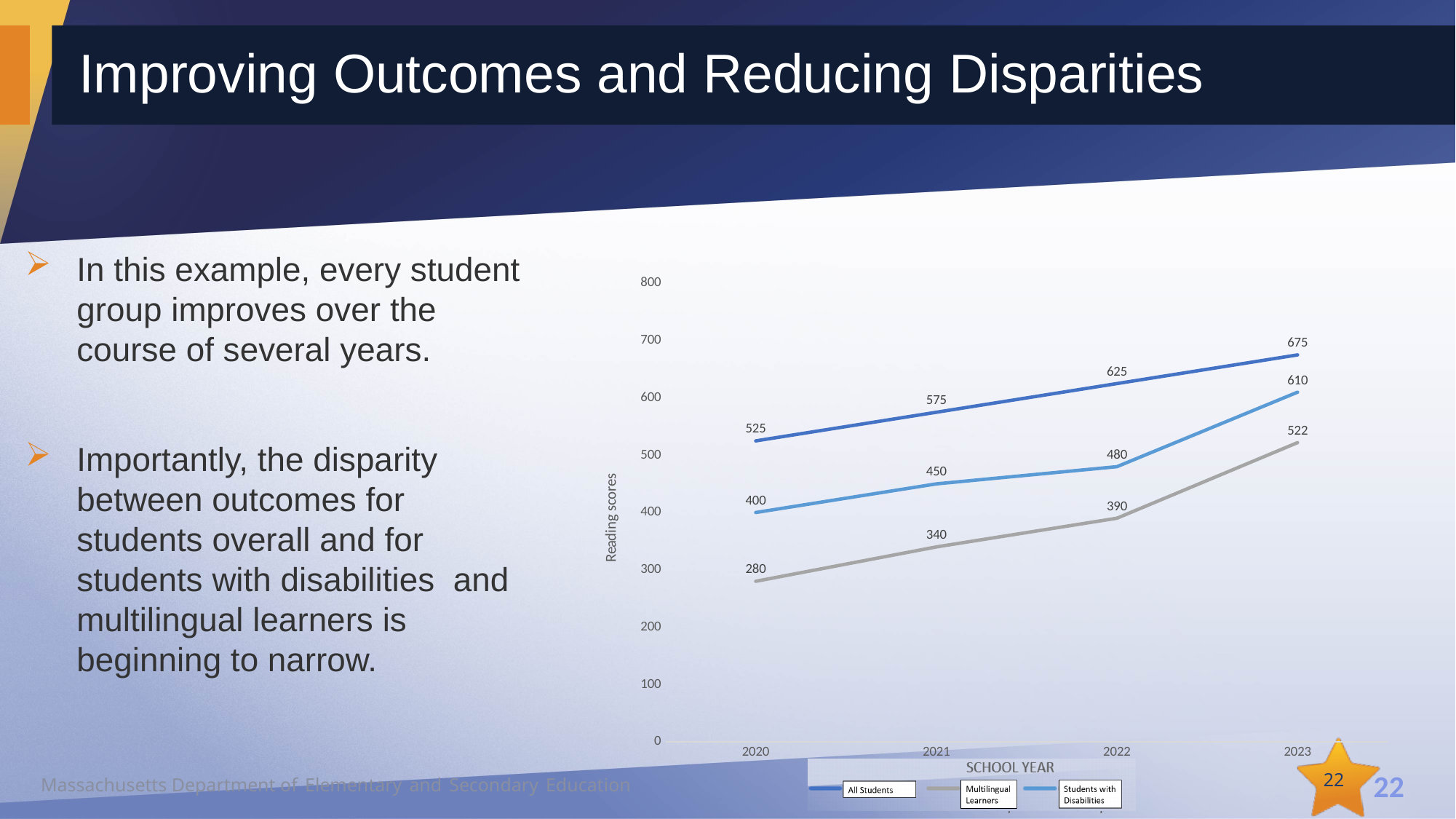
What is the reading score for Students with Disabilities in 2022? 480 Which school year has the lowest reading score for Multilingual Learners? 2020 What is the reading score for Multilingual Learners in 2020? 280 What is the difference between the All Students score and the Multilingual Learners score in 2020? 245 What type of chart is shown on the slide? line chart What is the difference between the Students with Disabilities score in 2023 and in 2022? 130 How many school years are plotted on the x axis? 4 Do the reading scores for Multilingual Learners rise or fall from 2020 to 2023? rise Which is larger in 2021: the score for Students with Disabilities or for Multilingual Learners? Students with Disabilities What is the reading score for All Students in 2023? 675 How many series does the legend list? 3 Which school year has the highest reading score for All Students? 2023